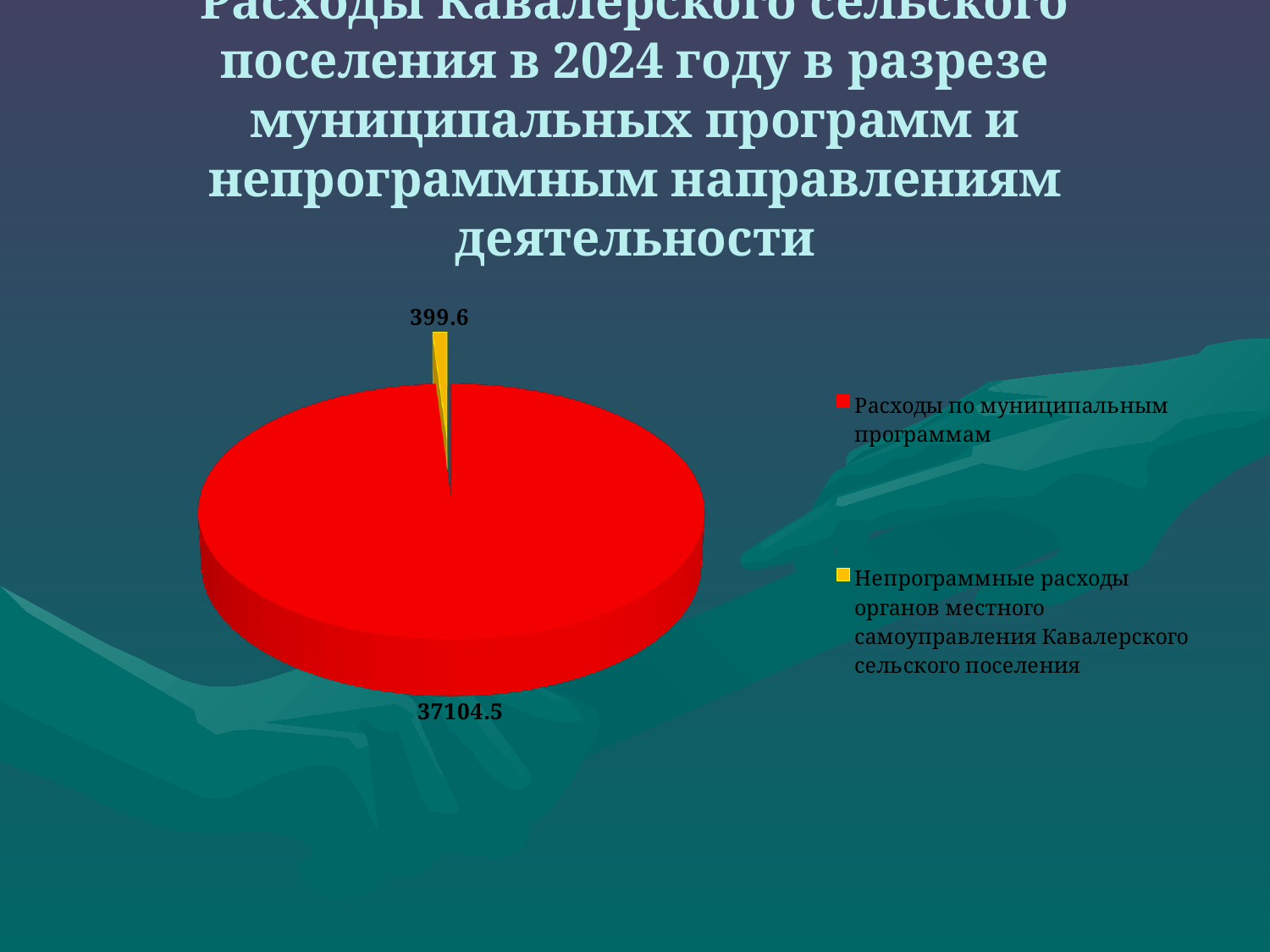
Which category has the largest slice of the pie? Расходы по муниципальным программам What is the value for Расходы по муниципальным программам? 37104.5 What kind of chart is shown on the slide? Pie chart What colour is the slice for Расходы по муниципальным программам? Red How many slices does the pie chart have? 2 What is the value for Непрограммные расходы органов местного самоуправления Кавалерского сельского поселения? 399.6 How many entries does the legend list? 2 Which category has the smallest slice of the pie? Непрограммные расходы органов местного самоуправления Кавалерского сельского поселения Which is larger: Расходы по муниципальным программам or Непрограммные расходы органов местного самоуправления Кавалерского сельского поселения? Расходы по муниципальным программам What is the total of the two values shown on the pie chart? 37504.1 What is the difference between the value for Расходы по муниципальным программам and the value for Непрограммные расходы органов местного самоуправления Кавалерского сельского поселения? 36704.9